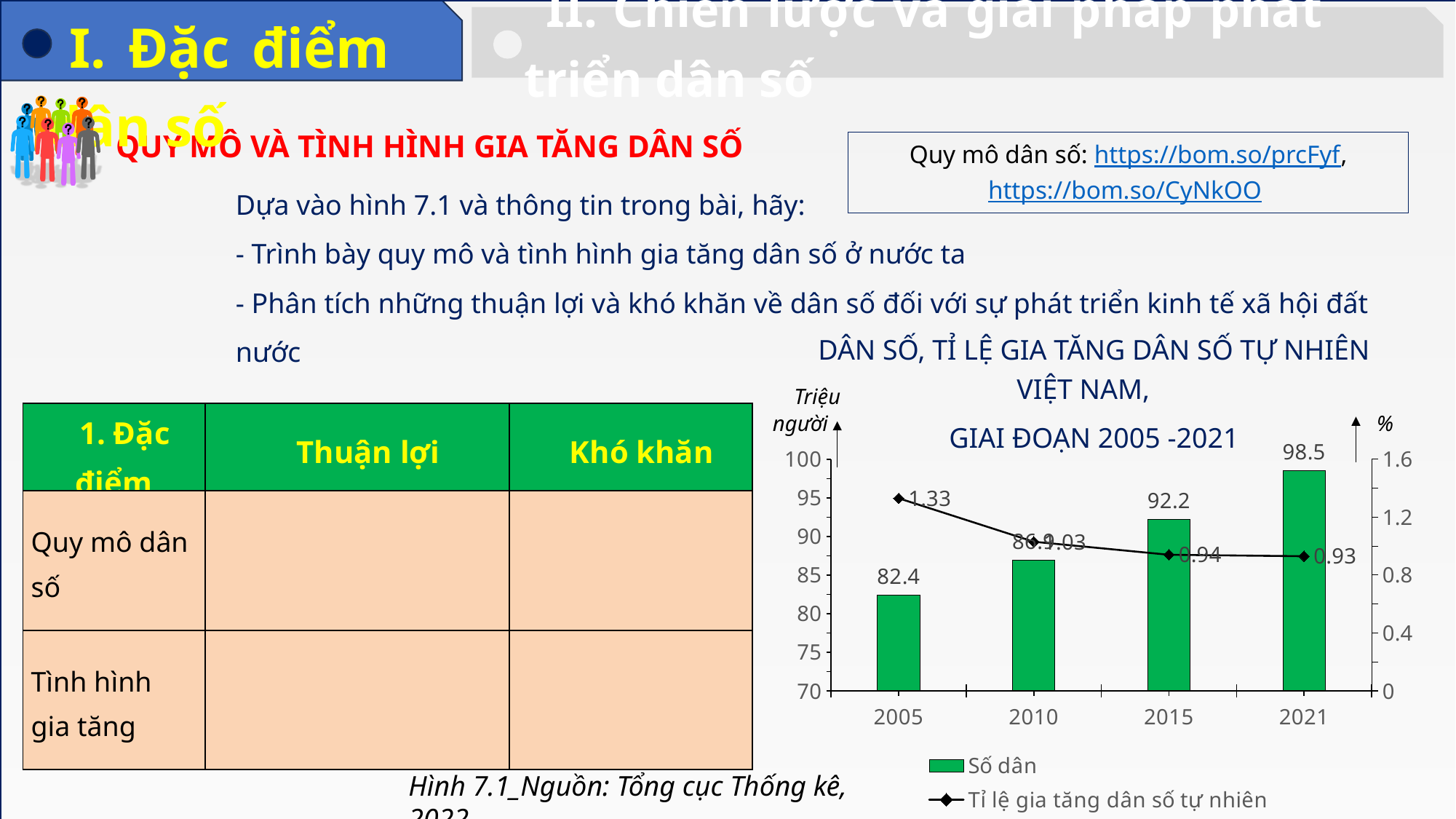
How many years are shown on the x axis? 4 What is the value of Số dân for 2005? 82.4 How does Tỉ lệ gia tăng dân số tự nhiên change from 2005 to 2021? It falls How many series does the legend list? 2 Which year has the highest Số dân? 2021 Is the Số dân value for 2010 greater or less than 85? greater What is the difference in Số dân between 2021 and 2005? 16.1 What is the value of Số dân for 2021? 98.5 Which year has the lowest Số dân? 2005 What is the Tỉ lệ gia tăng dân số tự nhiên for 2021? 0.93 What is the Tỉ lệ gia tăng dân số tự nhiên for 2005? 1.33 How does Số dân change from 2005 to 2021? It rises